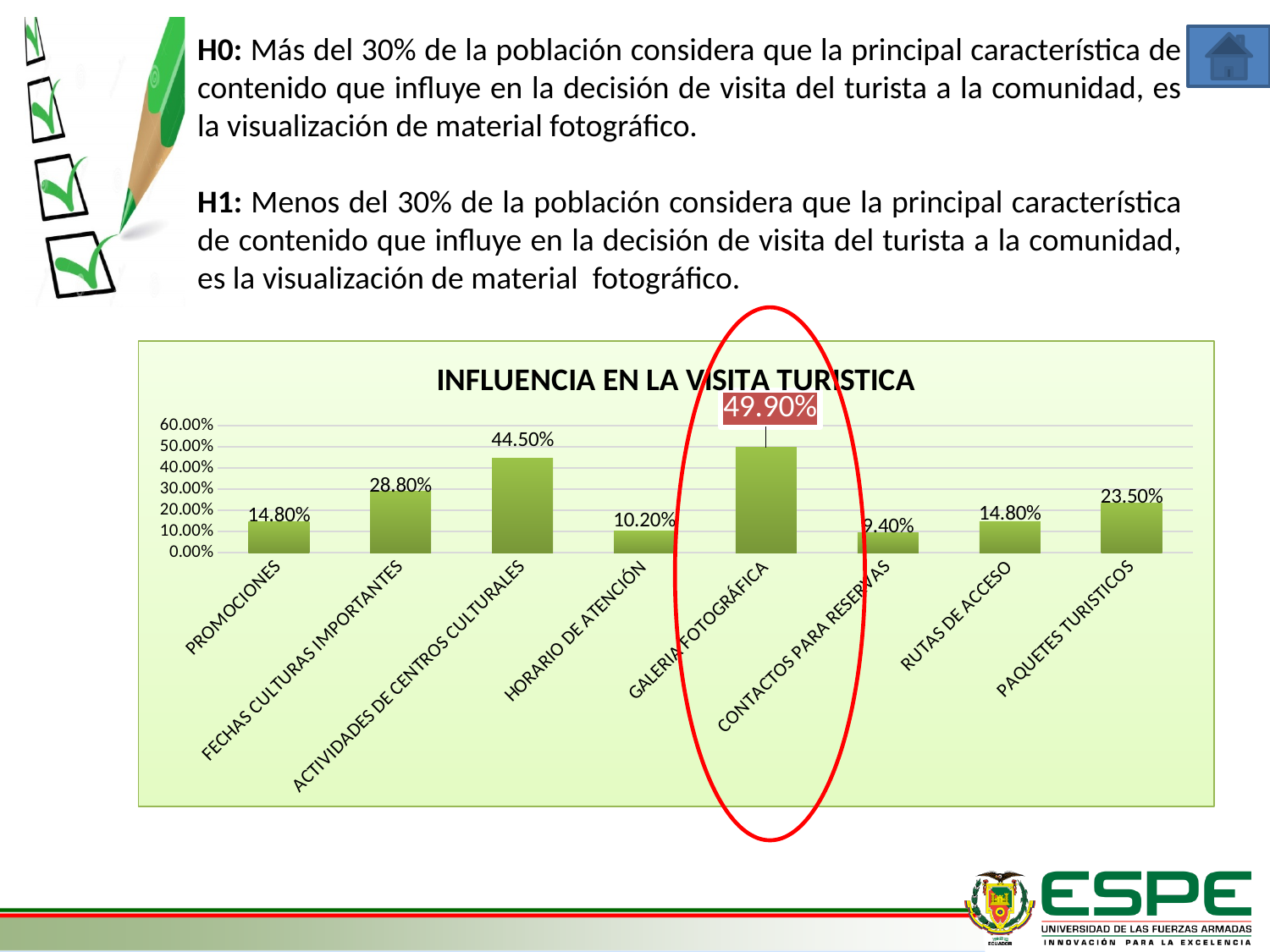
What is the value for ACTIVIDADES DE CENTROS CULTURALES? 44.50% What is the value for FECHAS CULTURAS IMPORTANTES? 28.80% What is the value for PAQUETES TURISTICOS? 23.50% How many categories are shown on the x axis? 8 What is the value for HORARIO DE ATENCIÓN? 10.20% What is the title of the chart? INFLUENCIA EN LA VISITA TURISTICA Which category has the highest value? GALERIA FOTOGRÁFICA What type of chart is shown on the slide? bar chart What is the difference between the values for GALERIA FOTOGRÁFICA and ACTIVIDADES DE CENTROS CULTURALES? 5.40% Which is larger, the value for FECHAS CULTURAS IMPORTANTES or the value for PAQUETES TURISTICOS? FECHAS CULTURAS IMPORTANTES Is the value for PROMOCIONES greater or less than 20.00%? less What is the value for GALERIA FOTOGRÁFICA? 49.90%